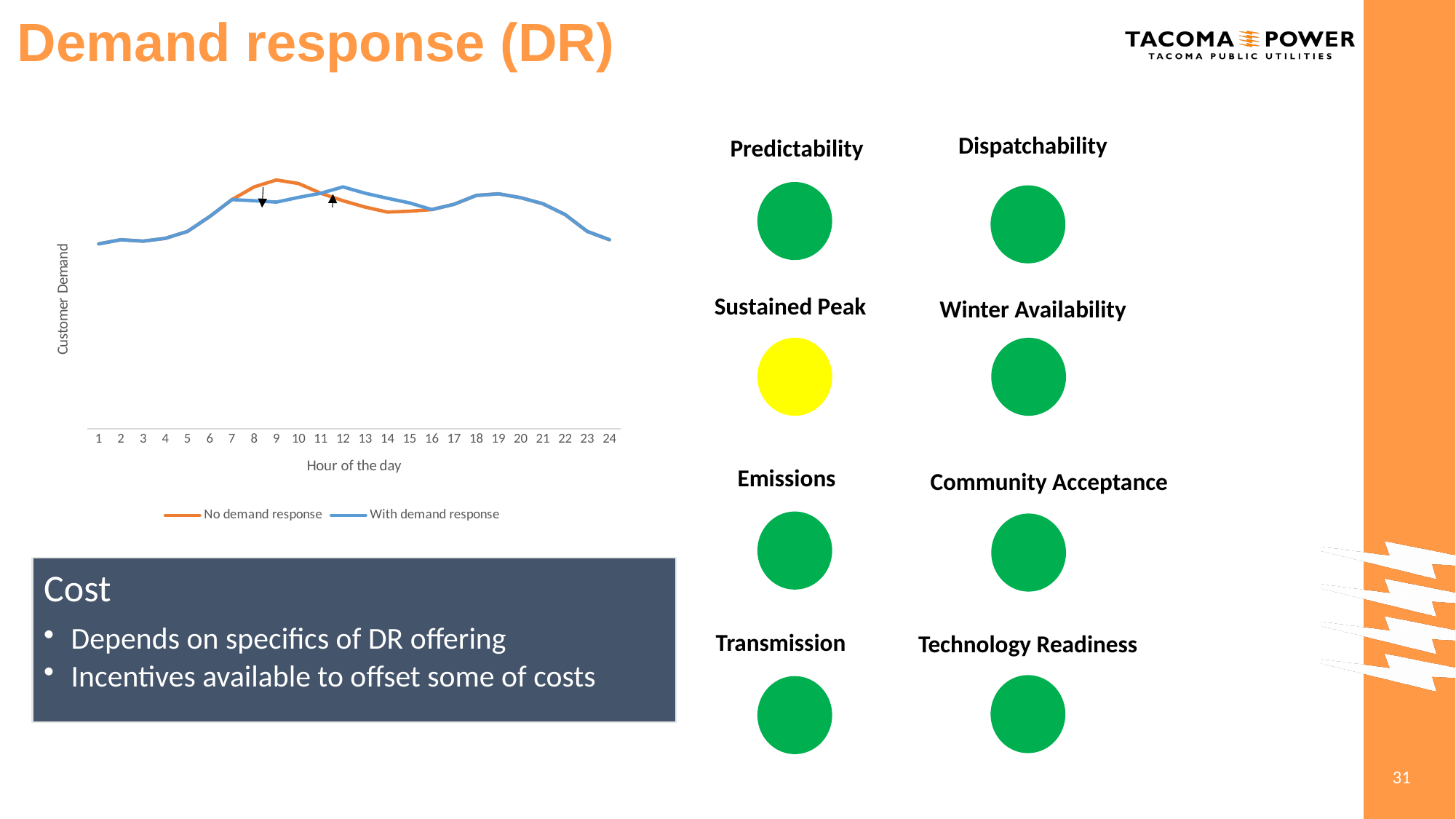
Does the With demand response series rise or fall between hour 19 and hour 24? Fall At which hour of the day does the No demand response series reach its highest value? 9 How many series does the chart legend list? 2 What kind of chart is shown on the slide? Line chart How many hours are shown along the x axis of the chart? 24 Does the No demand response series rise or fall between hour 9 and hour 14? Fall At hour 9, which series has the higher customer demand, No demand response or With demand response? No demand response At hour 14, which series has the higher customer demand, No demand response or With demand response? With demand response What are the two series named in the chart legend? No demand response; With demand response Does the No demand response series rise or fall between hour 1 and hour 9? Rise What is the x-axis title of the chart? Hour of the day